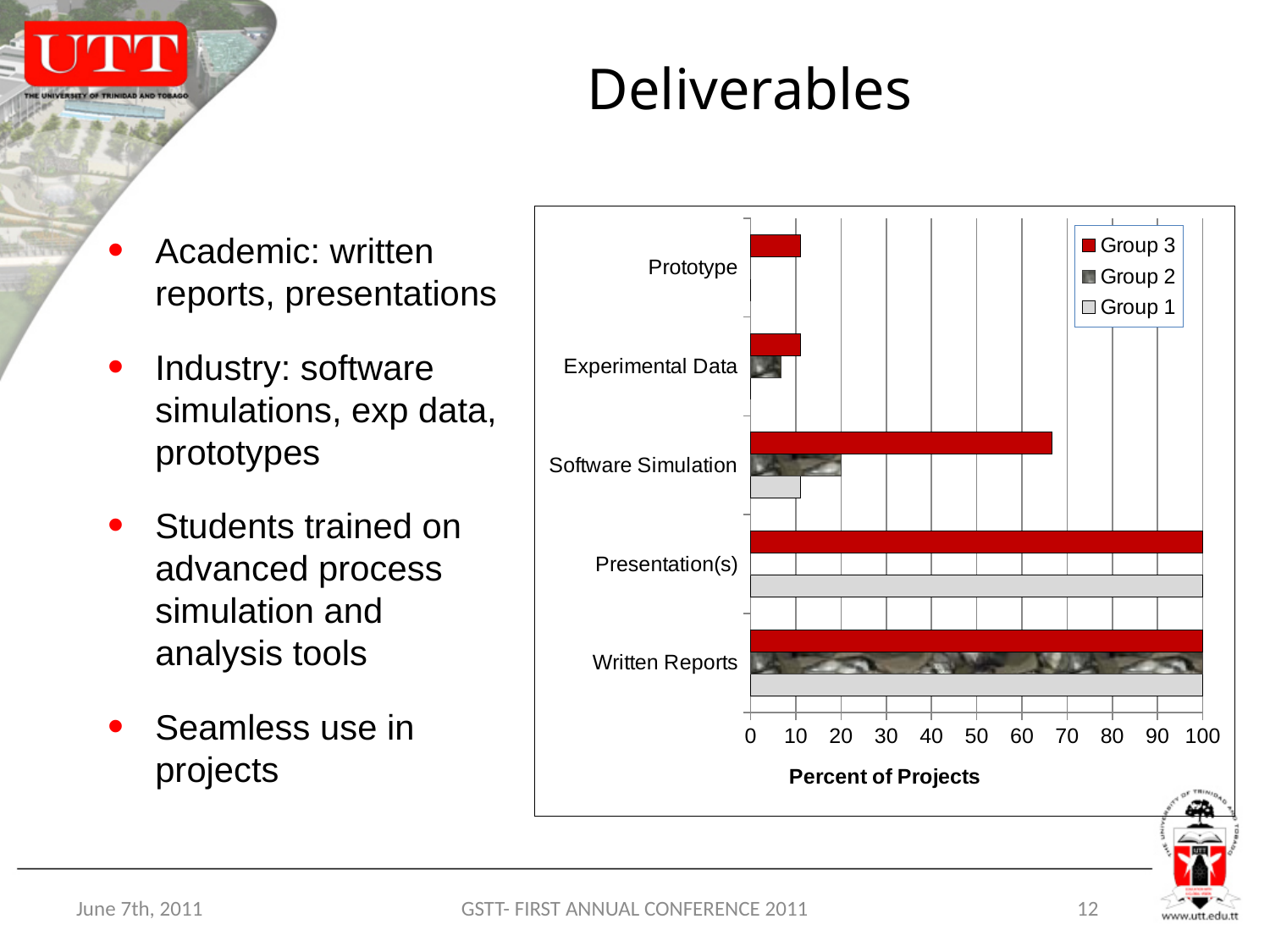
How many series does the chart's legend list? 3 Which series is shown in red in the chart's legend? Group 3 For Software Simulation, which is larger: the Group 3 value or the Group 1 value? Group 3 What is the Group 1 value for Presentation(s)? 100 What is the title of the horizontal axis of the chart? Percent of Projects How many categories are shown on the vertical axis of the chart? 5 Is the Group 3 value for Prototype greater or less than 20? less What kind of chart is shown on the slide? Bar chart Which has the larger Group 2 value: Software Simulation or Experimental Data? Software Simulation Is the Group 2 value for Experimental Data greater or less than 10? less Is the Group 3 value for Software Simulation greater or less than 60? greater What is the Group 3 value for Written Reports? 100